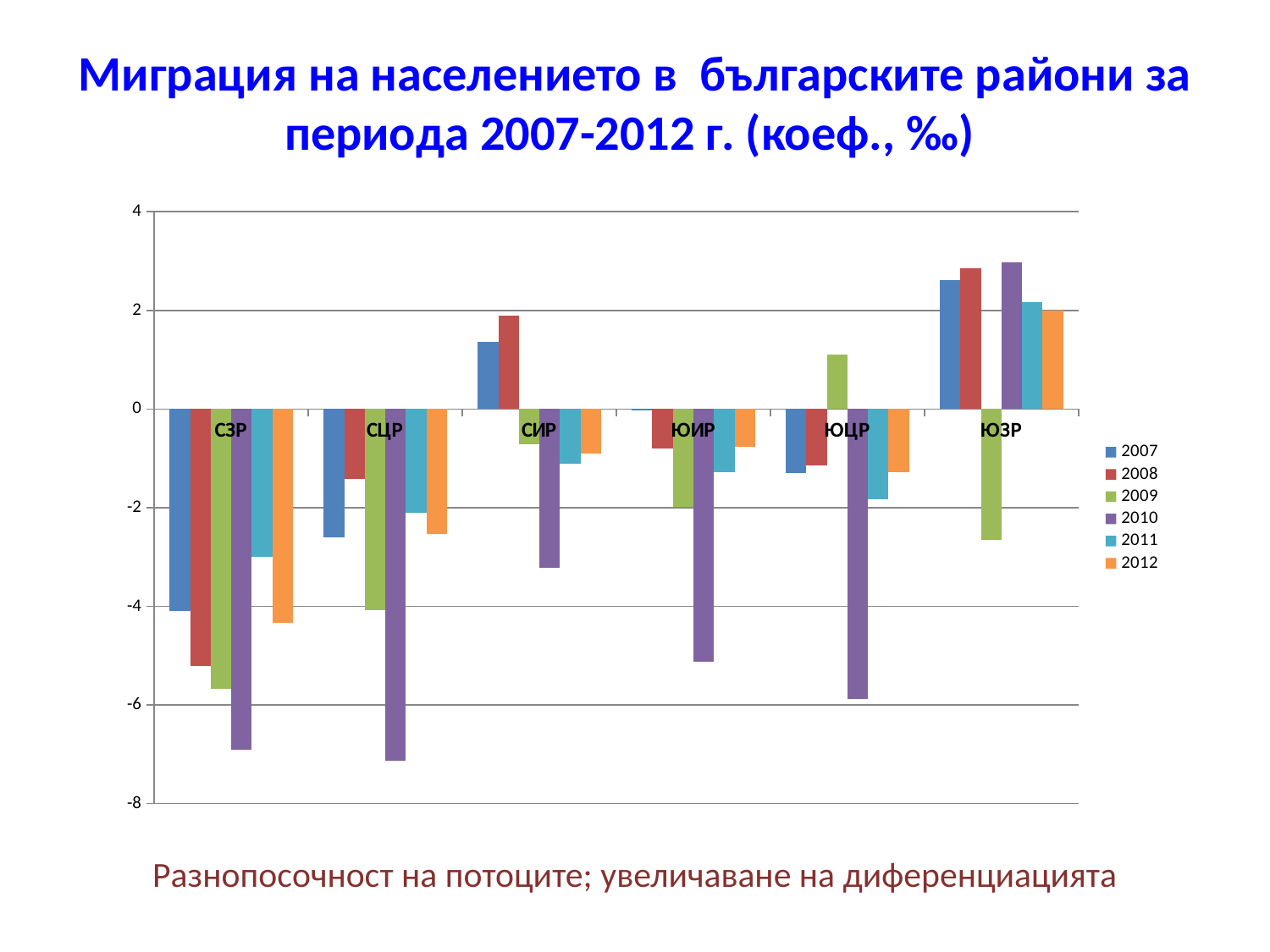
Which region has the lowest value for 2009? СЗР How many series does the chart legend list? 6 Which region has the highest value for 2008? ЮЗР Is the value for ЮЗР in 2010 greater or less than 2? greater Is the value for ЮЗР in 2009 greater or less than -2? less Is the value for СЦР in 2010 greater or less than -6? less Which years are listed in the chart legend? 2007, 2008, 2009, 2010, 2011, 2012 How many regions (categories) are shown on the x axis of the chart? 6 Which is larger, the 2007 value for СЗР or the 2007 value for СЦР? СЦР Which region has the highest value for 2010? ЮЗР What kind of chart is shown on the slide? bar chart